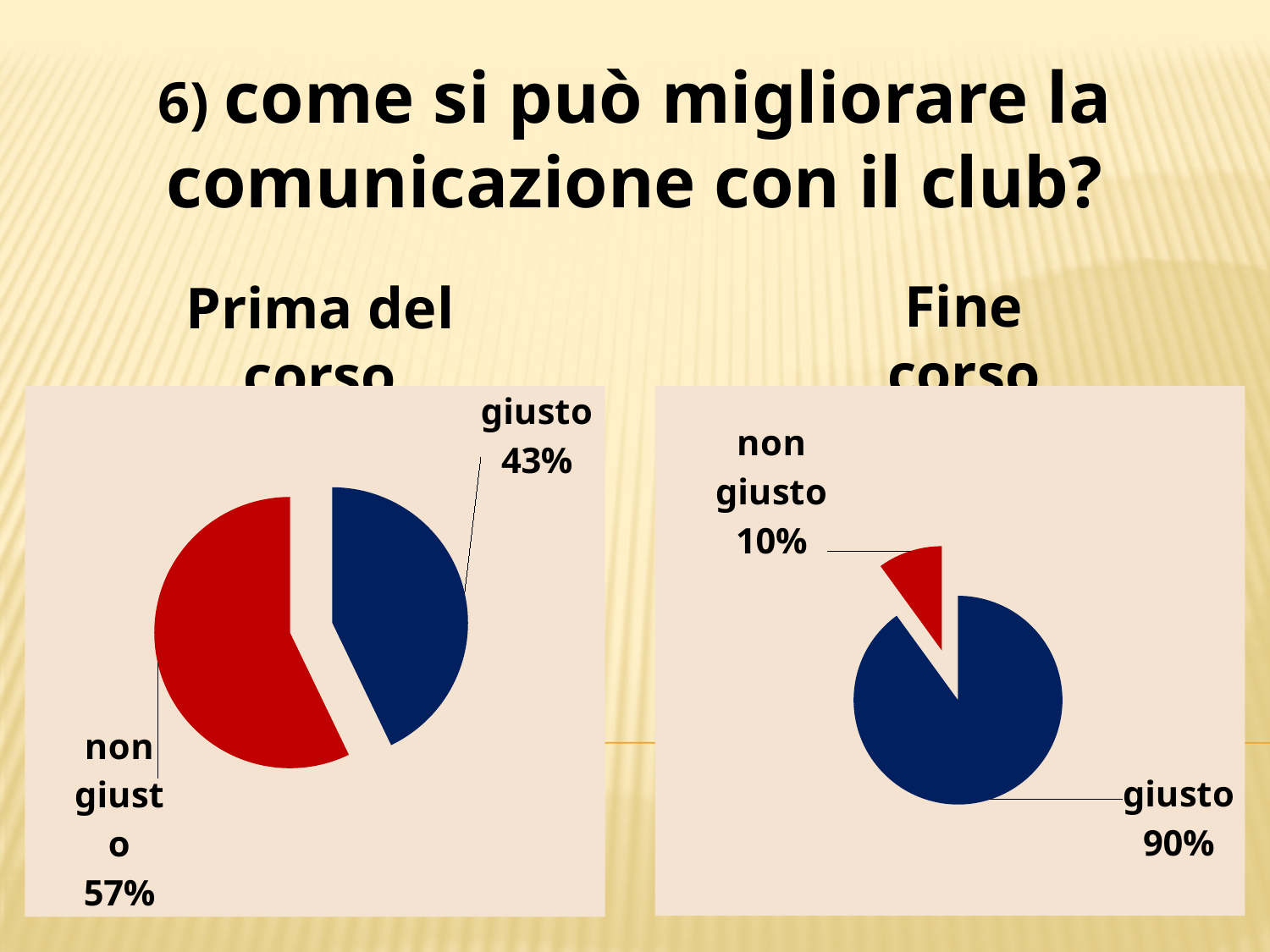
In the right pie chart (Fine corso), what is the share for "non giusto"? 10% In the left pie chart (Prima del corso), what is the share for "non giusto"? 57% In the right pie chart (Fine corso), what is the share for "giusto"? 90% In the left pie chart (Prima del corso), which slice is the largest? non giusto How many slices does the left pie chart (Prima del corso) have? 2 In the left pie chart (Prima del corso), what is the share for "giusto"? 43% Which is larger: the "giusto" share in the left chart (Prima del corso) or the "giusto" share in the right chart (Fine corso)? Fine corso In the left pie chart (Prima del corso), what is the difference between the "non giusto" and "giusto" shares? 14% What type of chart is used on the right (Fine corso)? Pie chart In the right pie chart (Fine corso), which slice is the smallest? non giusto In the right pie chart (Fine corso), what is the difference between the "giusto" and "non giusto" shares? 80% In the right pie chart (Fine corso), what colour is the "giusto" slice? Dark blue